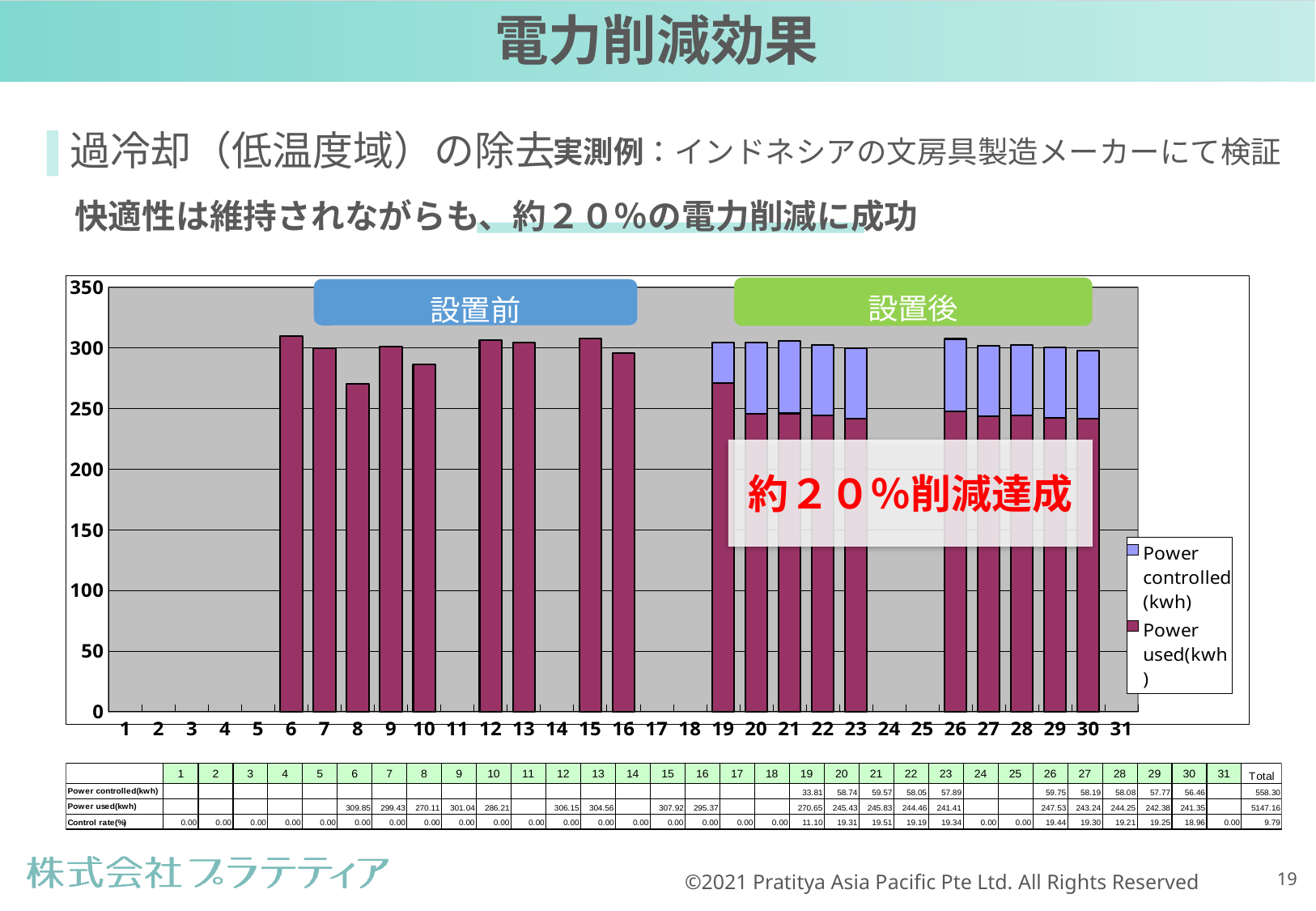
What is the Power used(kwh) value for day 6? 309.85 What is the Total value shown for Power controlled(kwh) in the table? 558.30 How many categories are shown along the x axis of the chart? 31 What is the total height of the stacked bar for day 20 (Power used plus Power controlled)? 304.17 What are the two series named in the chart legend? Power controlled(kwh) and Power used(kwh) How many series does the chart legend list? 2 Which is larger, the Power used(kwh) value for day 8 or for day 9? day 9 What is the difference between the Power used(kwh) values for day 6 and day 7? 10.42 What is the Power controlled(kwh) value for day 20? 58.74 Is the Power used(kwh) value for day 19 greater or less than 250? greater Which day has the highest Power used(kwh) value? 6 What kind of chart is shown on the slide? bar chart